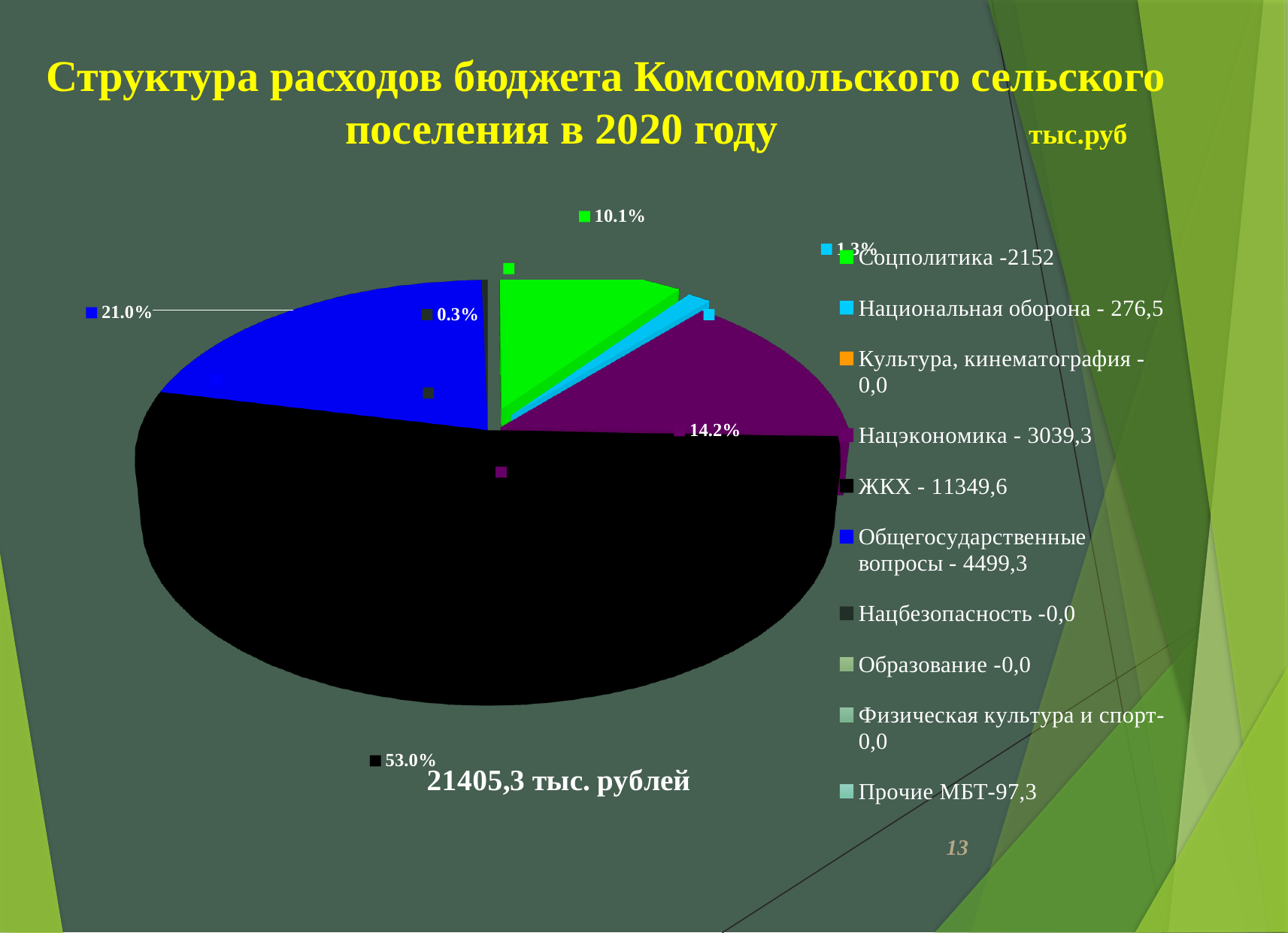
What is the value for Нацэкономика shown in the legend? 3039,3 What is the value for ЖКХ shown in the legend? 11349,6 What kind of chart is shown on the slide? pie chart Which category has the largest share of the pie? ЖКХ Which is larger, the value for Нацэкономика or the value for Соцполитика? Нацэкономика What percentage share of the pie does ЖКХ have? 53.0% What percentage share of the pie does Общегосударственные вопросы have? 21.0% What is the value for Прочие МБТ shown in the legend? 97,3 What total amount in тыс. рублей is printed below the pie chart? 21405,3 тыс. рублей What is the value for Общегосударственные вопросы shown in the legend? 4499,3 What is the value for Национальная оборона shown in the legend? 276,5 How many entries does the legend list? 10